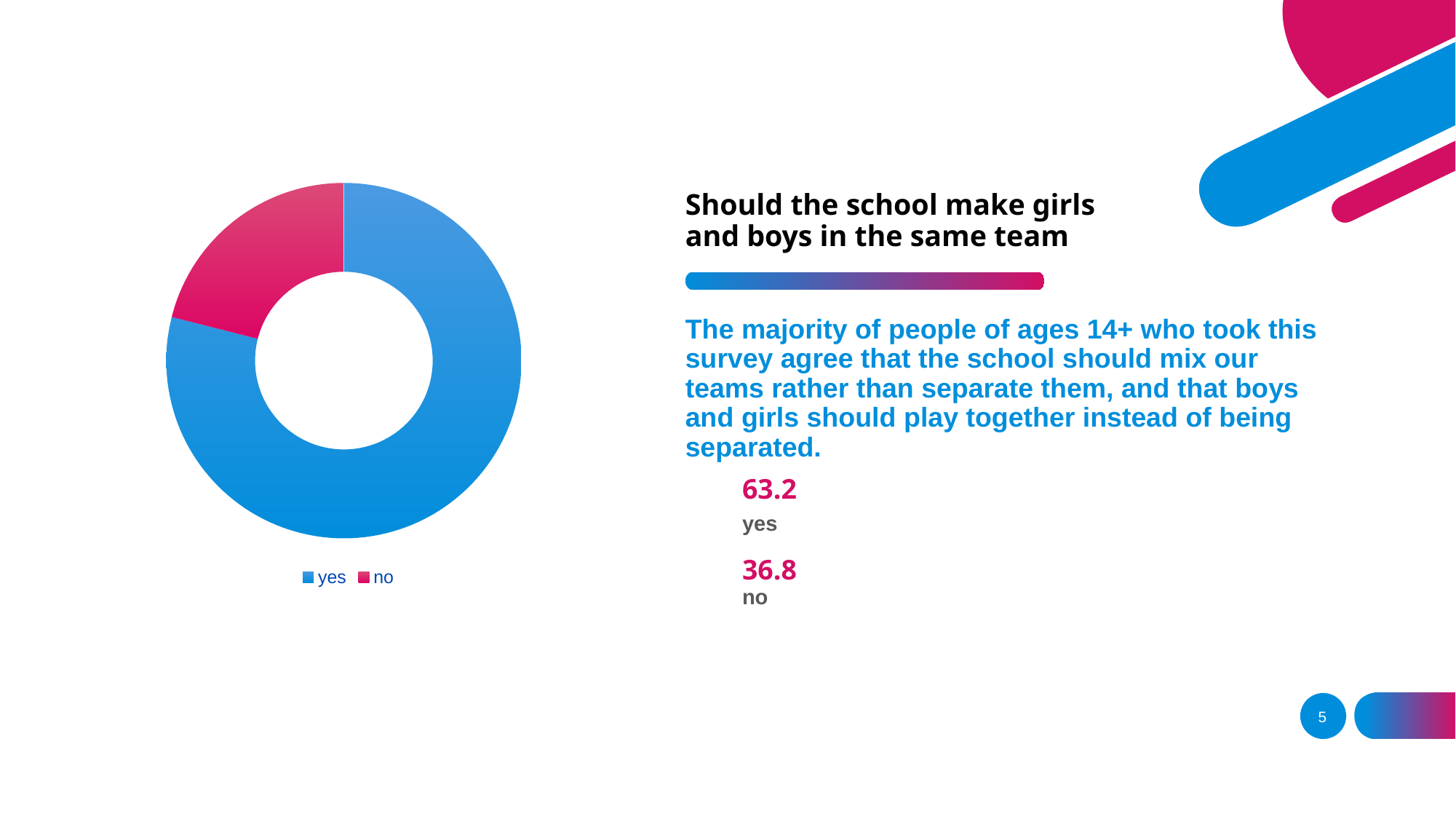
What value is given for no on the slide? 36.8 What colour is the yes slice of the chart? blue What are the two legend entries of the chart? yes, no Which slice is larger, yes or no? yes Which category has the largest slice of the chart? yes What value is given for yes on the slide? 63.2 What is the difference between the values for yes and no? 26.4 Which category has the smallest slice of the chart? no What kind of chart is shown on the slide? doughnut chart How many entries does the chart legend list? 2 How many categories does the chart show? 2